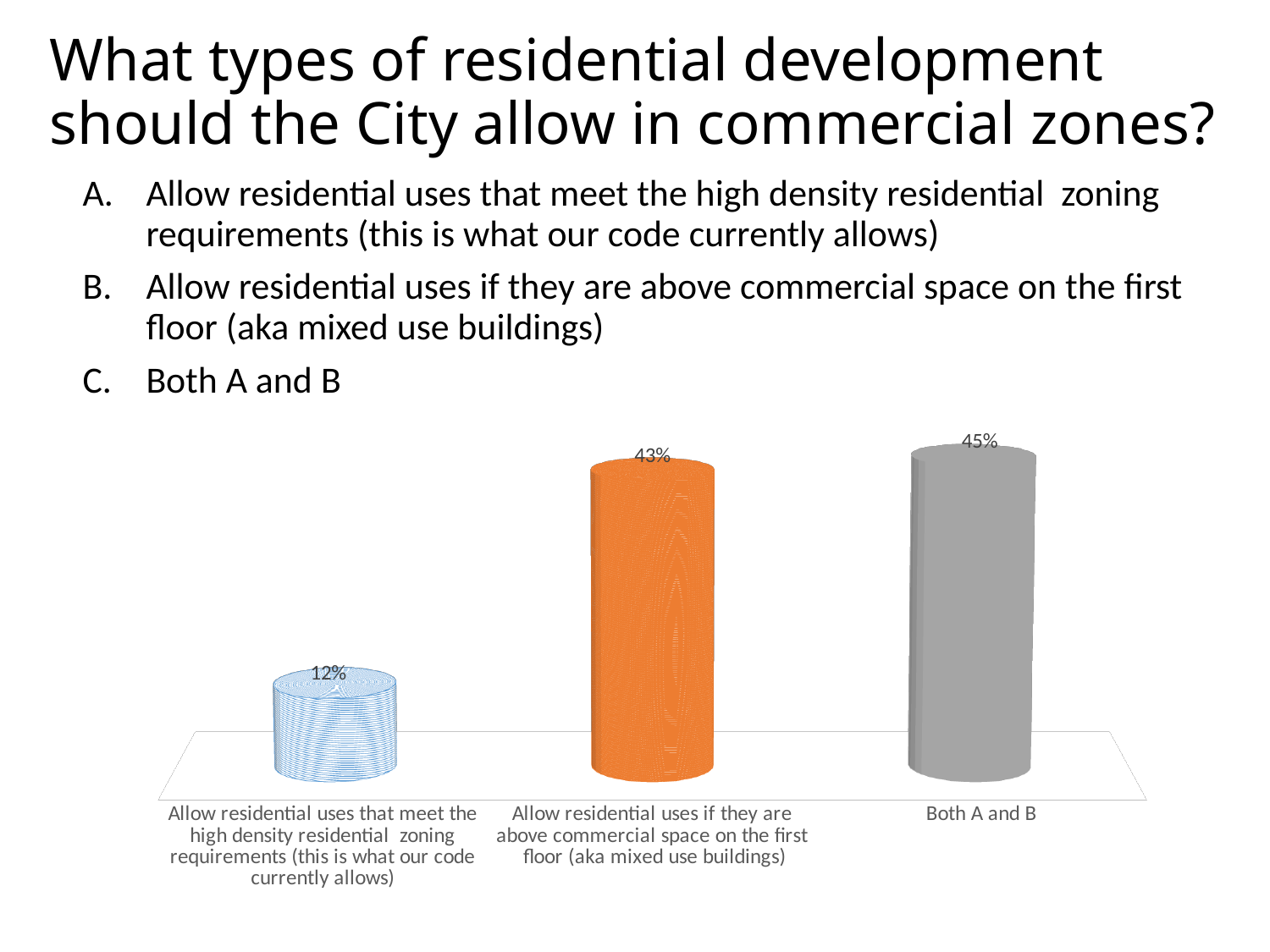
What colour is the bar for the mixed use buildings option? Orange What type of chart is shown on the slide? Bar chart What is the difference in percentage points between the mixed use buildings option and the high density residential zoning option? 31 percentage points Which received a larger share of responses: "Both A and B" or the high density residential zoning option? Both A and B Which option received the lowest percentage of responses? Allow residential uses that meet the high density residential zoning requirements (this is what our code currently allows) What percentage of responses chose "Allow residential uses that meet the high density residential zoning requirements (this is what our code currently allows)"? 12% What percentage of responses chose "Allow residential uses if they are above commercial space on the first floor (aka mixed use buildings)"? 43% What percentage of responses chose "Both A and B"? 45% Which option received the highest percentage of responses? Both A and B What is the difference in percentage points between "Both A and B" and the mixed use buildings option? 2 percentage points How many response options are shown in the chart? 3 What is the combined percentage of the three options shown in the chart? 100%